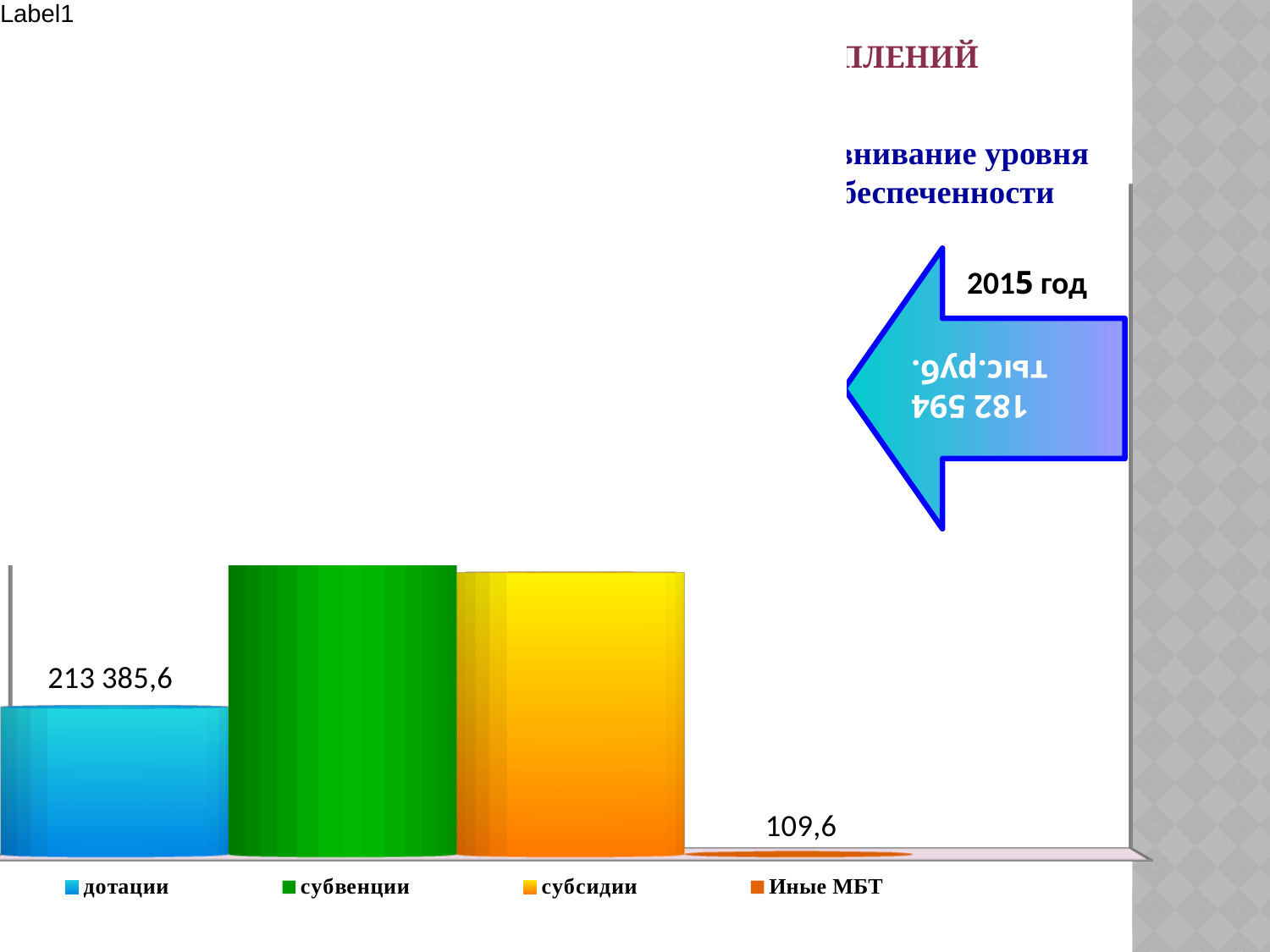
What colour represents субвенции in the chart? green Which is larger, субсидии or дотации? субсидии Which is larger, субвенции or дотации? субвенции How many entries does the legend list? 4 What is the value shown for Иные МБТ? 109,6 What is the difference between the values for дотации and Иные МБТ? 213 276,0 How many categories are shown in the chart? 4 What is the value shown for дотации? 213 385,6 What kind of chart is shown on the slide? bar chart Which is larger, дотации or Иные МБТ? дотации What colour represents дотации in the chart? blue Which category has the lowest value? Иные МБТ